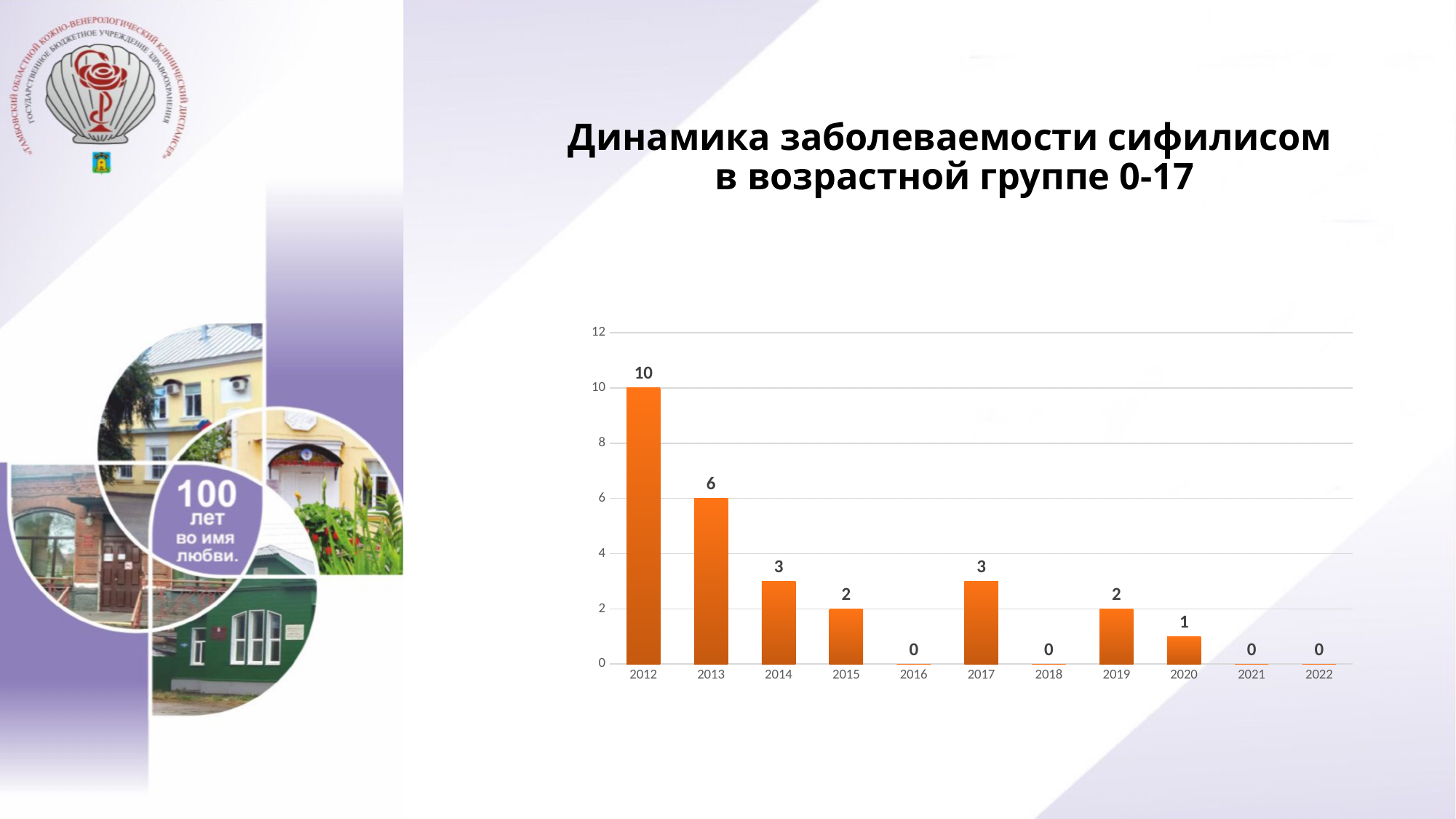
What is the value for 2020? 1 What is the value for 2013? 6 What is the difference between the values for 2014 and 2015? 1 Which year has the highest value? 2012 What is the value for 2012? 10 What is the value for 2016? 0 What is the title of the slide? Динамика заболеваемости сифилисом в возрастной группе 0-17 What kind of chart is shown on the slide? bar chart How many years are shown on the x axis? 11 Do the values generally rise or fall from 2012 to 2022? fall What is the difference between the values for 2012 and 2013? 4 Which is larger, the value for 2017 or the value for 2019? 2017